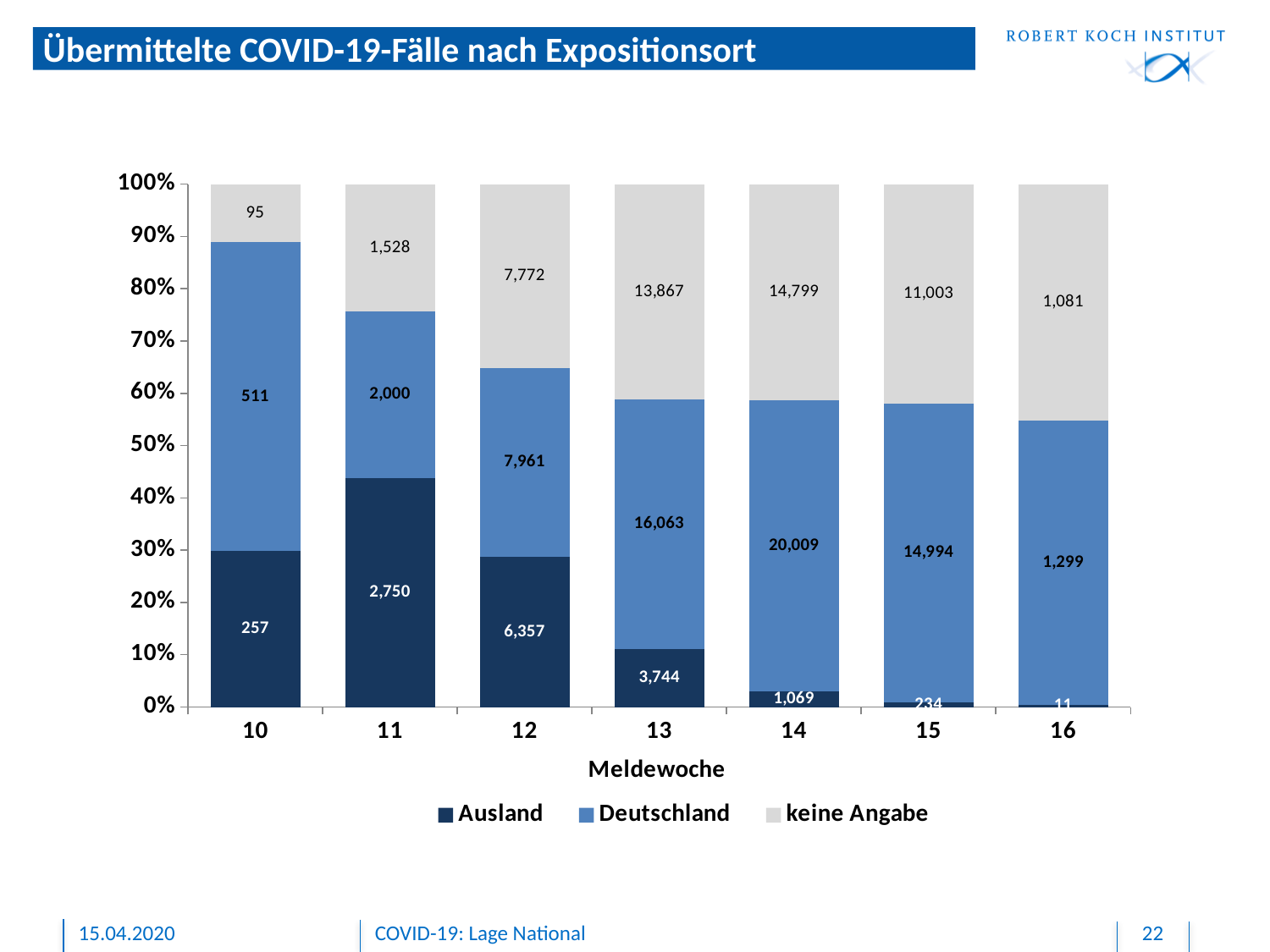
What kind of chart is shown on the slide? stacked bar chart What is the difference between the Deutschland and Ausland values in Meldewoche 12? 1,604 In which Meldewoche is the Ausland value lowest? 16 What is the value for Ausland in Meldewoche 12? 6,357 In which Meldewoche is the Deutschland value highest? 14 How many Meldewochen are shown on the x axis? 7 How many series does the legend list? 3 What is the total of the three labelled values in the bar for Meldewoche 10? 863 Which is larger in Meldewoche 11: the Ausland value or the Deutschland value? Ausland Is the share of the bar taken by Ausland in Meldewoche 11 greater or less than 40%? greater What is the value for Deutschland in Meldewoche 14? 20,009 What is the value for keine Angabe in Meldewoche 13? 13,867